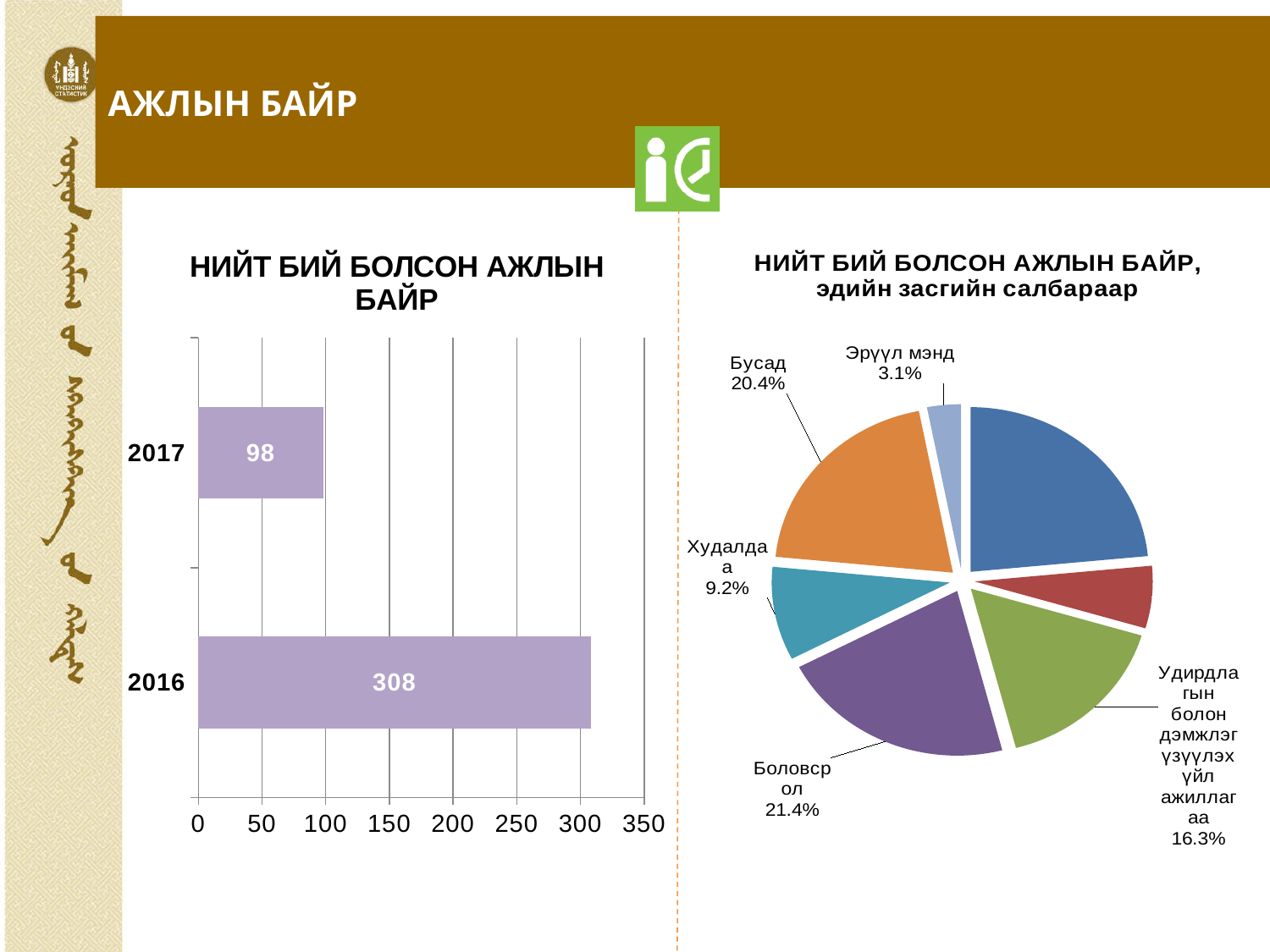
In the bar chart on the left, which year has the lower value? 2017 What kind of chart is the chart on the left of the slide? bar chart In the pie chart on the right, what share does Боловсрол have? 21.4% In the bar chart on the left, what is the difference between the values for 2016 and 2017? 210 In the pie chart on the right, which is larger: Бусад or Худалдаа? Бусад In the bar chart on the left, which year has the higher value? 2016 In the bar chart on the left, is the value for 2016 greater or less than 300? greater In the bar chart on the left, how many years are shown? 2 In the bar chart on the left, what is the value for 2017? 98 In the bar chart on the left, what is the value for 2016? 308 In the pie chart on the right, what share does Эрүүл мэнд have? 3.1% What kind of chart is the chart on the right of the slide? pie chart